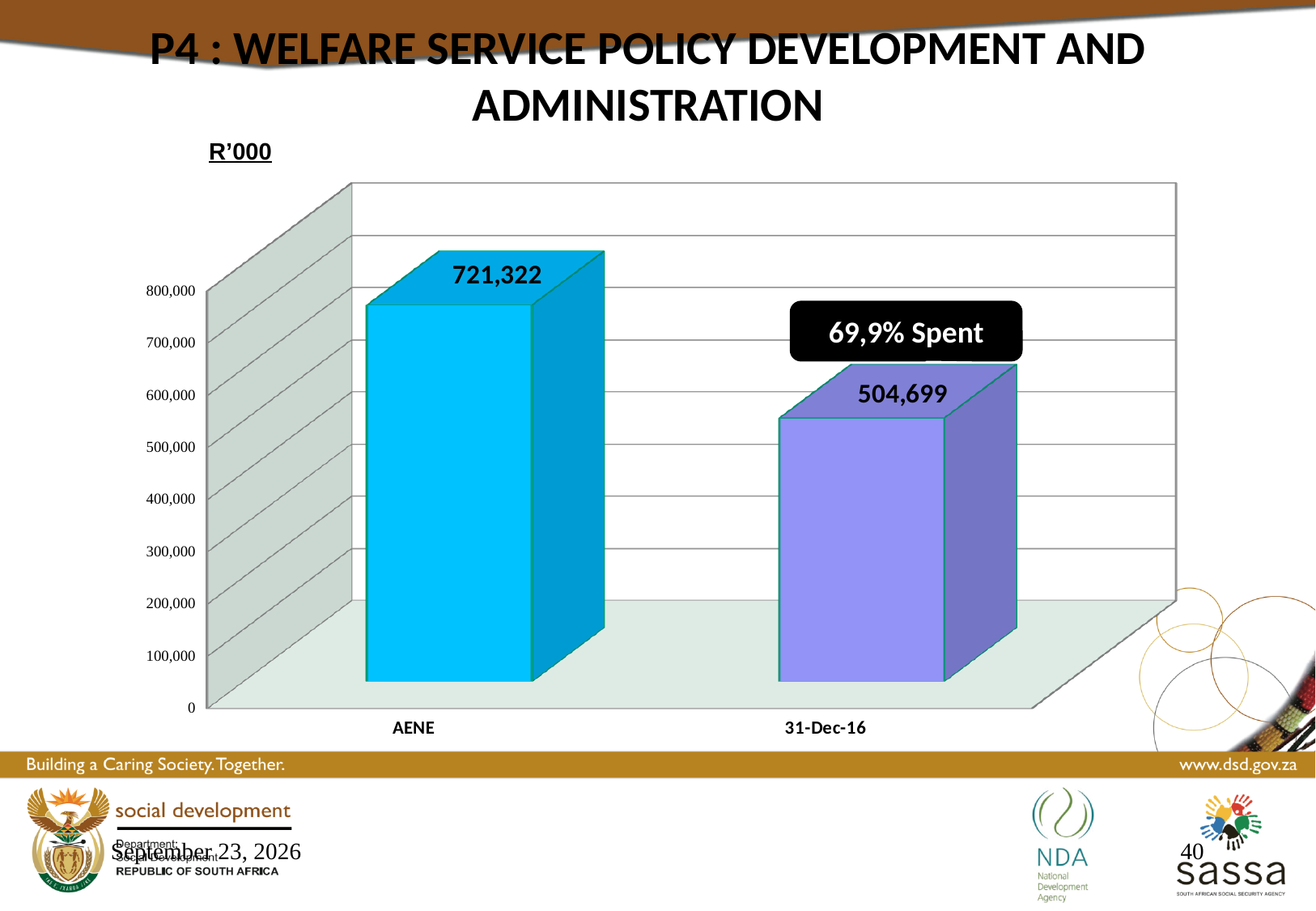
How many bars are plotted in the chart? 2 What is the value of the AENE bar? 721,322 Which category has the highest value? AENE Which category has the lowest value? 31-Dec-16 What unit label is shown above the chart? R'000 Is the value for 31-Dec-16 greater or less than 600,000? less What percentage spent is shown in the callout on the chart? 69,9% Spent What kind of chart is shown on the slide? bar chart What is the value of the 31-Dec-16 bar? 504,699 Is the value for AENE greater or less than 700,000? greater Which category has the higher value, AENE or 31-Dec-16? AENE What is the difference between the AENE value and the 31-Dec-16 value? 216,623